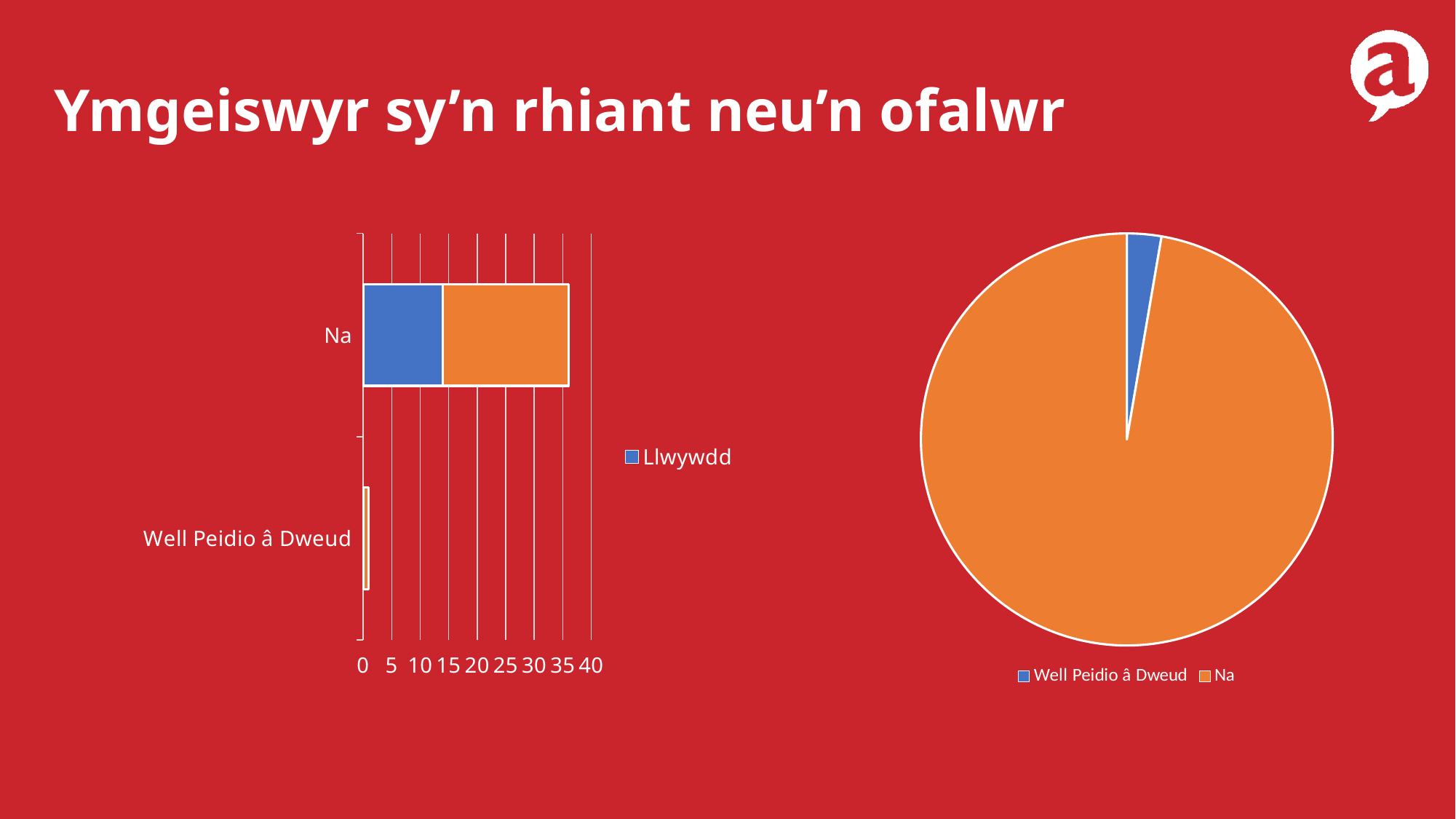
In the bar chart on the left, is the blue segment of the Na bar greater or less than 10? greater In the bar chart on the left, which category has the shortest bar? Well Peidio â Dweud In the bar chart on the left, is the value for Well Peidio â Dweud greater or less than 5? less In the bar chart on the left, is the total length of the bar for Na greater or less than 30? greater In the bar chart on the left, how many categories are shown on the vertical axis? 2 In the pie chart on the right, which slice is the largest? Na In the bar chart on the left, which bar is longer: Na or Well Peidio â Dweud? Na In the bar chart on the left, which category has the longest bar? Na What kind of chart is the chart on the left of the slide? bar chart In the bar chart on the left, what is the highest value shown on the horizontal axis? 40 In the pie chart on the right, how many entries does the legend list? 2 What kind of chart is the chart on the right of the slide? pie chart